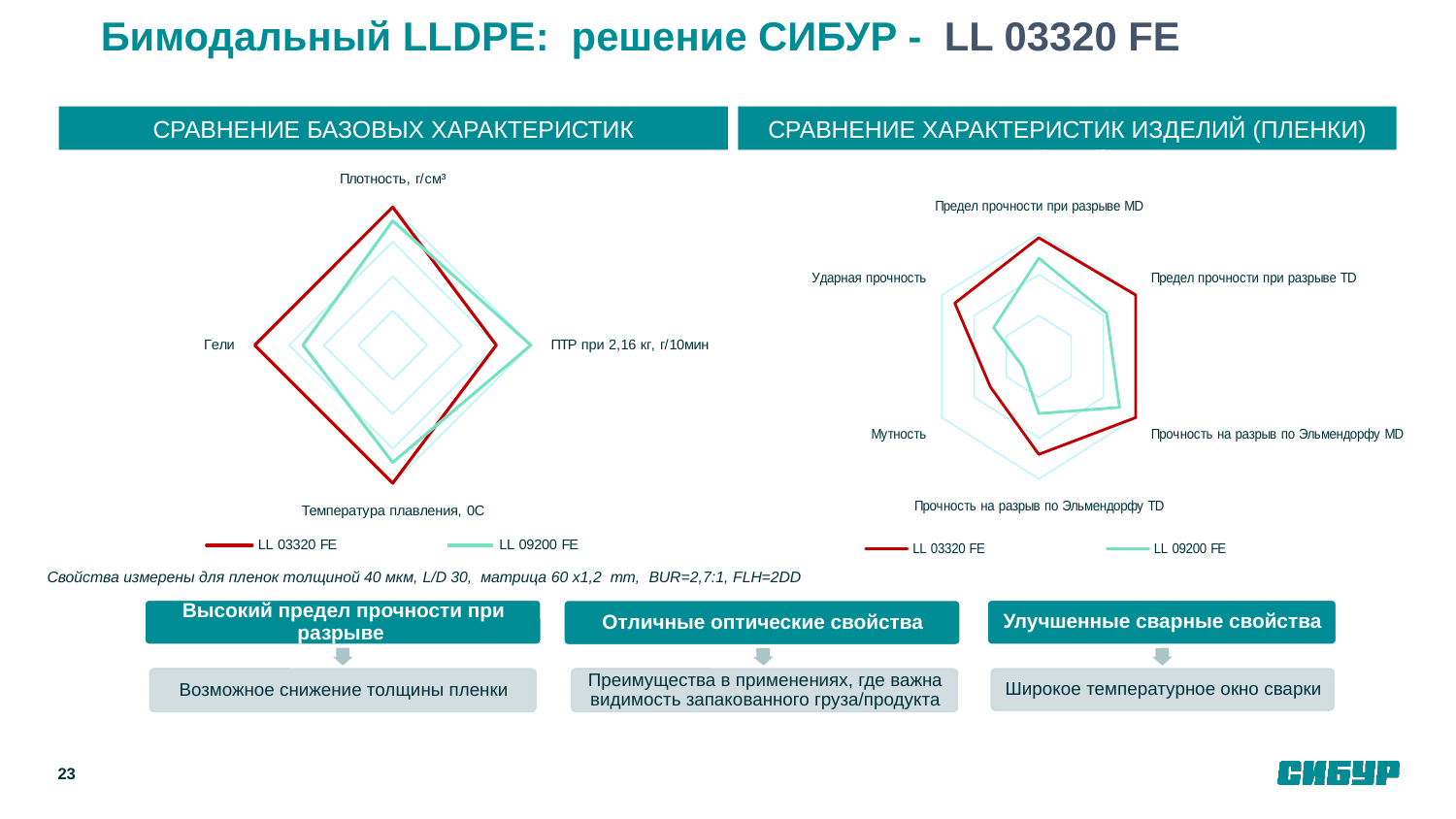
In the chart 'СРАВНЕНИЕ БАЗОВЫХ ХАРАКТЕРИСТИК', which series is drawn in red? LL 03320 FE In the chart 'СРАВНЕНИЕ БАЗОВЫХ ХАРАКТЕРИСТИК', which series has the larger value for 'Гели', LL 03320 FE or LL 09200 FE? LL 03320 FE What are the two series named in the legend of the chart 'СРАВНЕНИЕ ХАРАКТЕРИСТИК ИЗДЕЛИЙ (ПЛЕНКИ)'? LL 03320 FE and LL 09200 FE How many axes (categories) does the chart 'СРАВНЕНИЕ БАЗОВЫХ ХАРАКТЕРИСТИК' have? 4 What kind of chart is the chart titled 'СРАВНЕНИЕ БАЗОВЫХ ХАРАКТЕРИСТИК'? Radar chart In the chart 'СРАВНЕНИЕ БАЗОВЫХ ХАРАКТЕРИСТИК', which series has the larger value for 'ПТР при 2,16 кг, г/10мин', LL 03320 FE or LL 09200 FE? LL 09200 FE How many axes (categories) does the chart 'СРАВНЕНИЕ ХАРАКТЕРИСТИК ИЗДЕЛИЙ (ПЛЕНКИ)' have? 6 How many series does the legend of the chart 'СРАВНЕНИЕ ХАРАКТЕРИСТИК ИЗДЕЛИЙ (ПЛЕНКИ)' list? 2 What kind of chart is the chart titled 'СРАВНЕНИЕ ХАРАКТЕРИСТИК ИЗДЕЛИЙ (ПЛЕНКИ)'? Radar chart How many series does the legend of the chart 'СРАВНЕНИЕ БАЗОВЫХ ХАРАКТЕРИСТИК' list? 2 In the chart 'СРАВНЕНИЕ ХАРАКТЕРИСТИК ИЗДЕЛИЙ (ПЛЕНКИ)', which series has the larger value for 'Прочность на разрыв по Эльмендорфу TD', LL 03320 FE or LL 09200 FE? LL 03320 FE